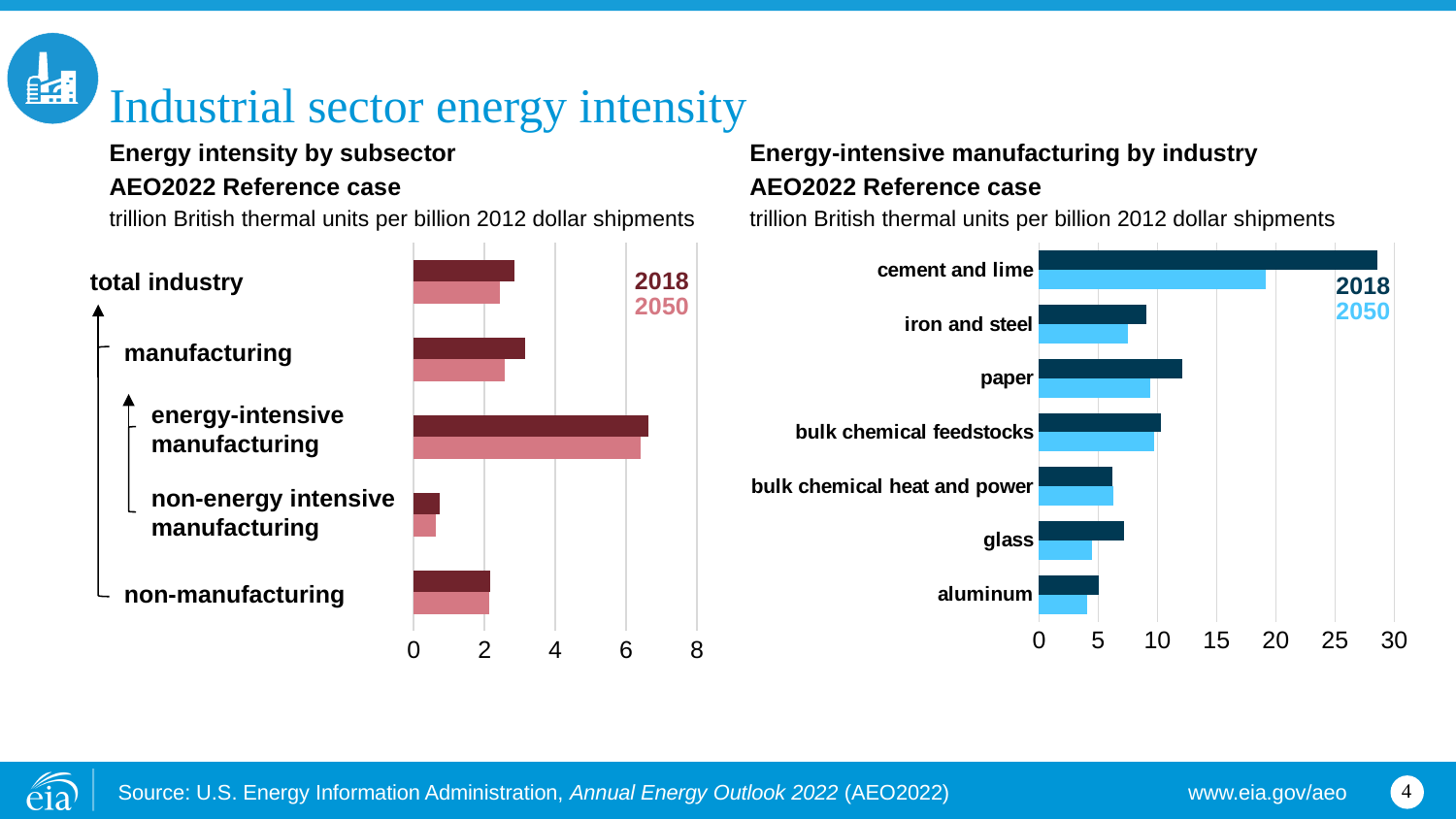
In the 'Energy-intensive manufacturing by industry' chart, which is larger in 2018: paper or iron and steel? paper In the 'Energy-intensive manufacturing by industry' chart, is the 2018 value for cement and lime greater or less than 25? greater In the 'Energy intensity by subsector' chart, is the 2018 value for non-energy intensive manufacturing greater or less than 2? less In the 'Energy intensity by subsector' chart, which is larger in 2018: manufacturing or non-manufacturing? manufacturing In the 'Energy-intensive manufacturing by industry' chart, how many industries are plotted? 7 In the 'Energy intensity by subsector' chart, which category has the highest 2018 value? energy-intensive manufacturing In the 'Energy intensity by subsector' chart, what kind of chart is shown? bar chart In the 'Energy intensity by subsector' chart, how many series does the legend list? 2 In the 'Energy-intensive manufacturing by industry' chart, which industry has the highest 2018 value? cement and lime In the 'Energy intensity by subsector' chart, which category has the lowest 2018 value? non-energy intensive manufacturing In the 'Energy intensity by subsector' chart, is the 2018 value for energy-intensive manufacturing greater or less than 6? greater In the 'Energy intensity by subsector' chart, how many subsector categories are plotted? 5